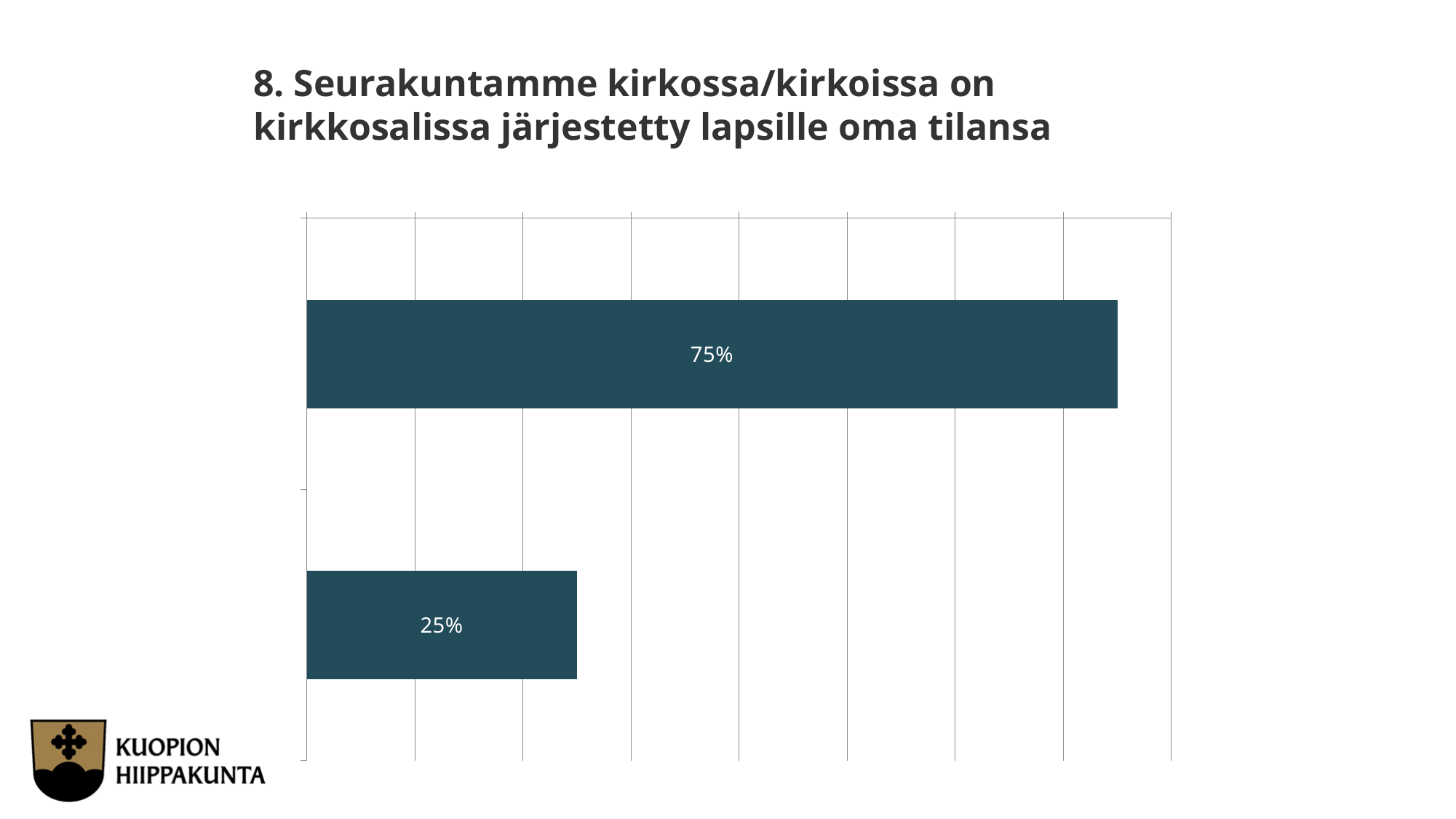
Are the bars in the chart oriented horizontally or vertically? horizontally What is the value shown on the top bar? 75% Which bar has the lowest value, the top or the bottom one? bottom What is the difference between the top bar's value and the bottom bar's value? 50% What is the title of the chart? 8. Seurakuntamme kirkossa/kirkoissa on kirkkosalissa järjestetty lapsille oma tilansa Is the value of the top bar larger or smaller than the value of the bottom bar? larger What kind of chart is shown on the slide? bar chart What is the value shown on the bottom bar? 25% Which bar has the highest value, the top or the bottom one? top How many bars are plotted in the chart? 2